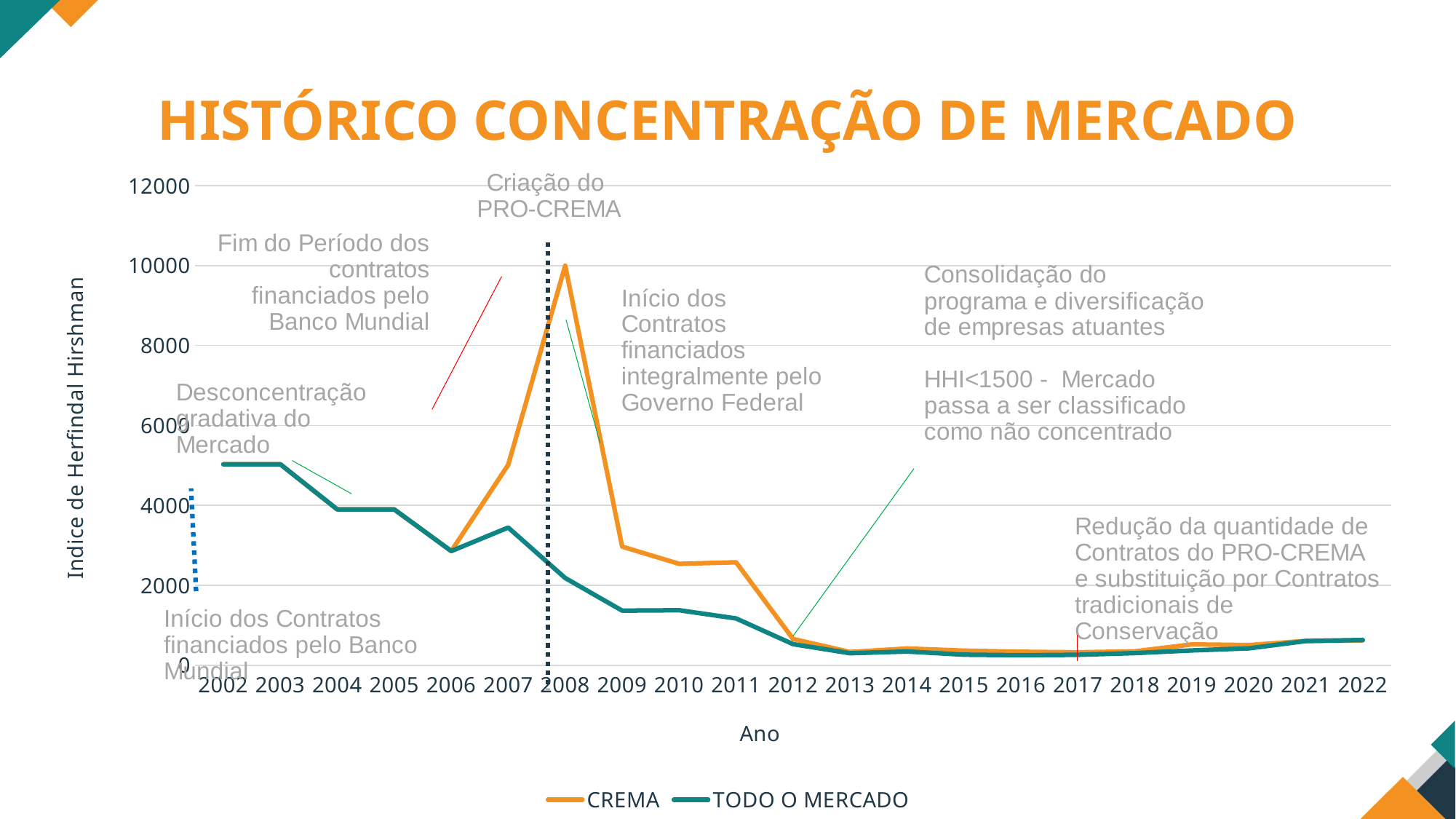
How many years are shown on the x axis? 21 What kind of chart is shown on the slide? line chart Is the value for TODO O MERCADO in 2012 greater or less than 2000? less In which year does the CREMA series reach its highest value? 2008 In 2010, which series has the larger value, CREMA or TODO O MERCADO? CREMA Is the value for CREMA in 2009 greater or less than 2000? greater How many series does the legend list? 2 What is the value of the CREMA series in 2008? 10000 Is the value for TODO O MERCADO in 2006 greater or less than 4000? less Does the TODO O MERCADO series rise or fall from 2002 to 2013? fall What is the label of the vertical axis? Indice de Herfindal Hirshman